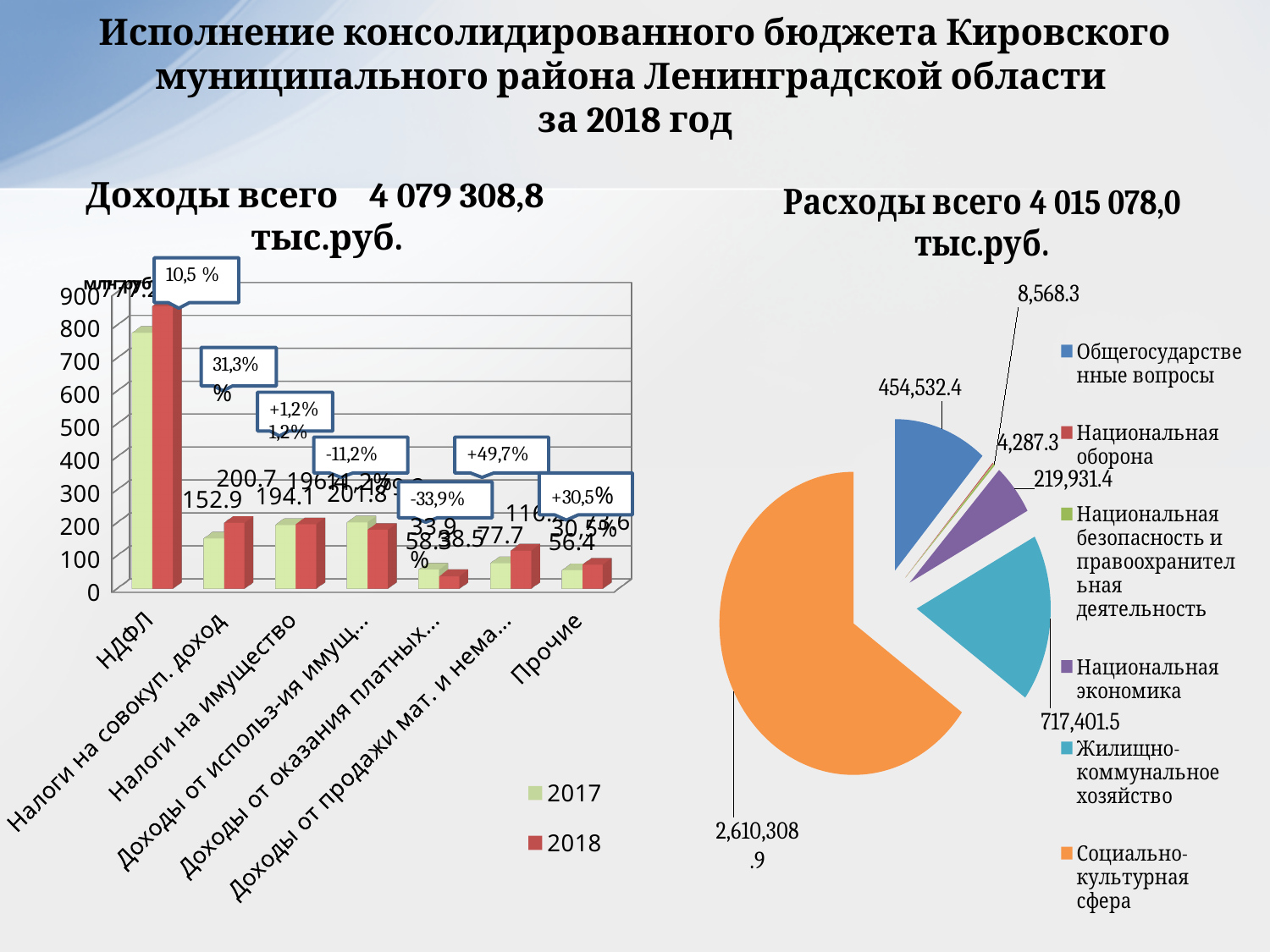
In the left bar chart (Доходы всего), how many categories are shown on the x axis? 7 In the right pie chart (Расходы всего), what is the value for "Жилищно-коммунальное хозяйство"? 717,401.5 What kind of chart is the left chart titled "Доходы всего 4 079 308,8 тыс.руб."? bar chart In the left bar chart (Доходы всего), which category has the highest values? НДФЛ In the left bar chart (Доходы всего), what is the difference between the 2018 and 2017 values for "Налоги на совокуп. доход"? 47.8 In the left bar chart (Доходы всего), is the 2018 value for НДФЛ greater or less than 800? greater What kind of chart is the right chart titled "Расходы всего 4 015 078,0 тыс.руб."? pie chart In the left bar chart (Доходы всего), how many series does the legend list? 2 In the left bar chart (Доходы всего), what is the 2018 value for "Налоги на совокуп. доход"? 200.7 In the right pie chart (Расходы всего), which category has the largest slice? Социально-культурная сфера In the right pie chart (Расходы всего), how many slices are there? 6 In the left bar chart (Доходы всего), what is the 2017 value for "Налоги на совокуп. доход"? 152.9